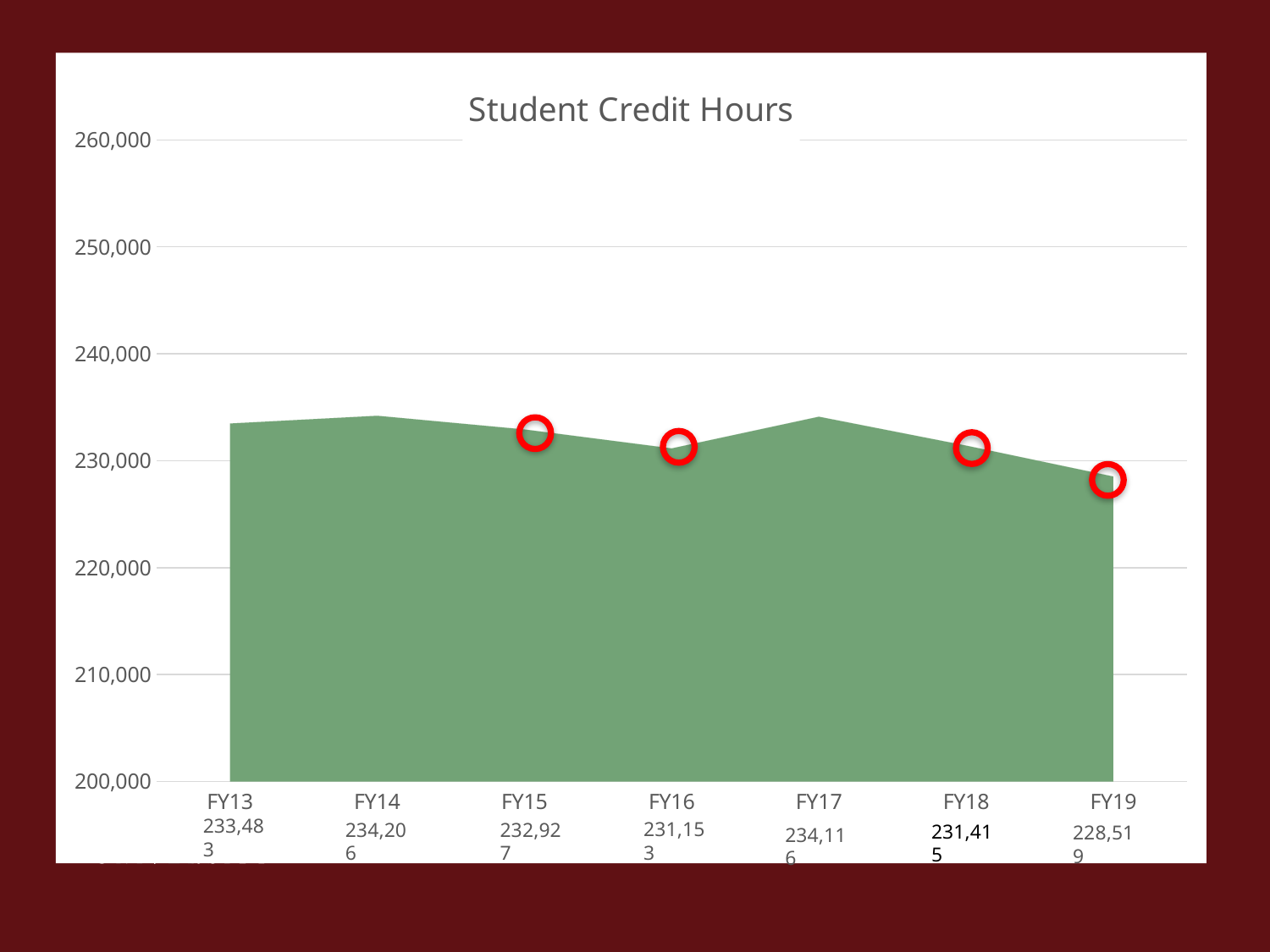
What is the value for FY13? 233,483 Is the value for FY19 greater or less than 230,000? less What is the difference between the FY13 value and the FY19 value? 4,964 What is the value for FY16? 231,153 What is the value for FY19? 228,519 How many fiscal years are plotted on the chart? 7 What kind of chart is shown on the slide? area chart What is the title of the chart? Student Credit Hours What is the difference between the FY17 value and the FY18 value? 2,701 What is the value for FY18? 231,415 Which is larger, the value for FY15 or the value for FY16? FY15 Which fiscal year has the lowest student credit hours? FY19